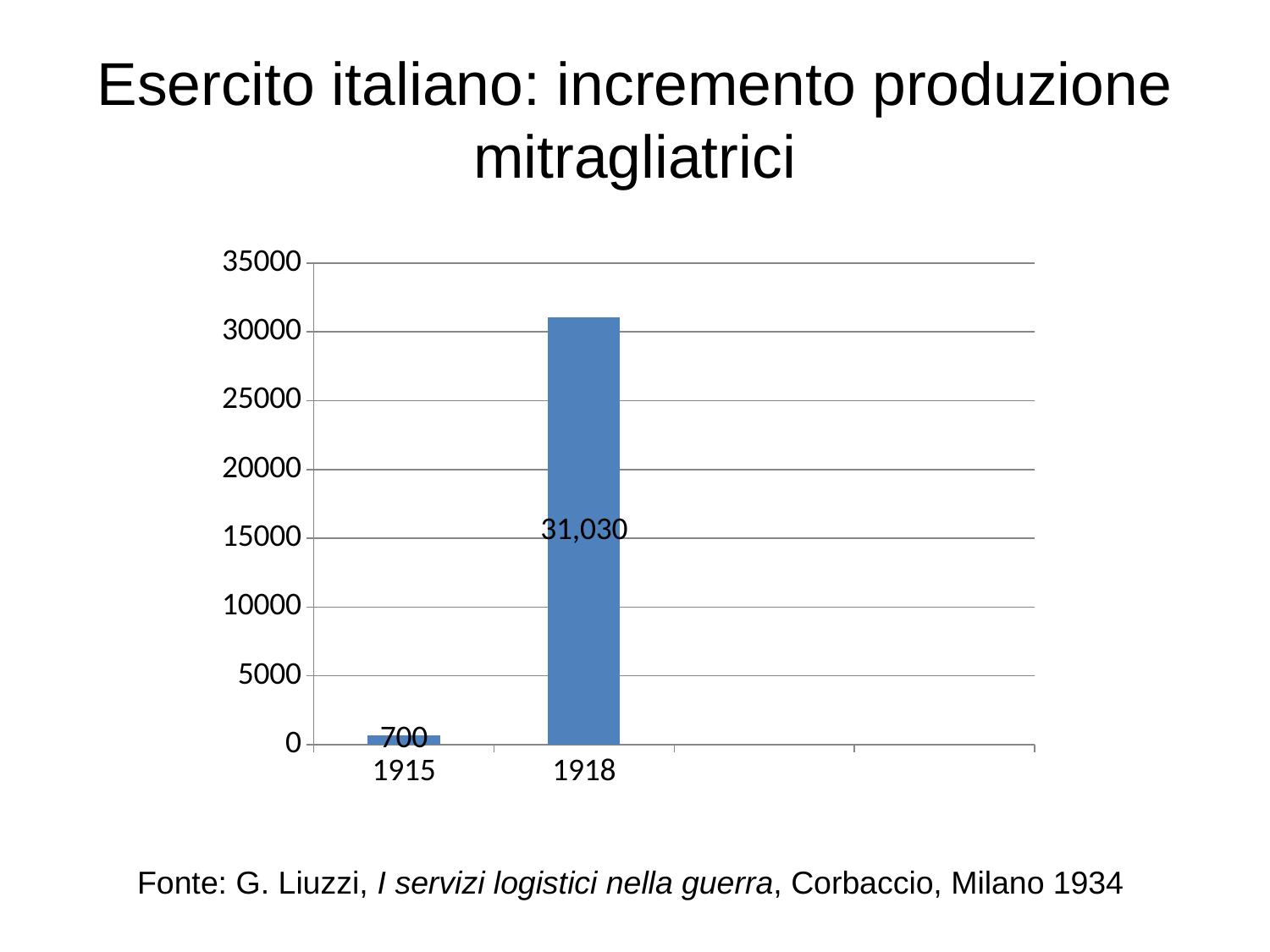
Is the value for 1915 greater or less than 5000? less Which is larger, the value for 1915 or the value for 1918? 1918 What is the value for 1915? 700 Do the values rise or fall from 1915 to 1918? rise What is the value for 1918? 31,030 What kind of chart is shown on the slide? bar chart Which year has the lowest value? 1915 What is the title of the slide? Esercito italiano: incremento produzione mitragliatrici Is the value for 1918 greater or less than 30000? greater How many years are shown on the chart? 2 What is the difference between the values for 1918 and 1915? 30,330 Which year has the highest value? 1918